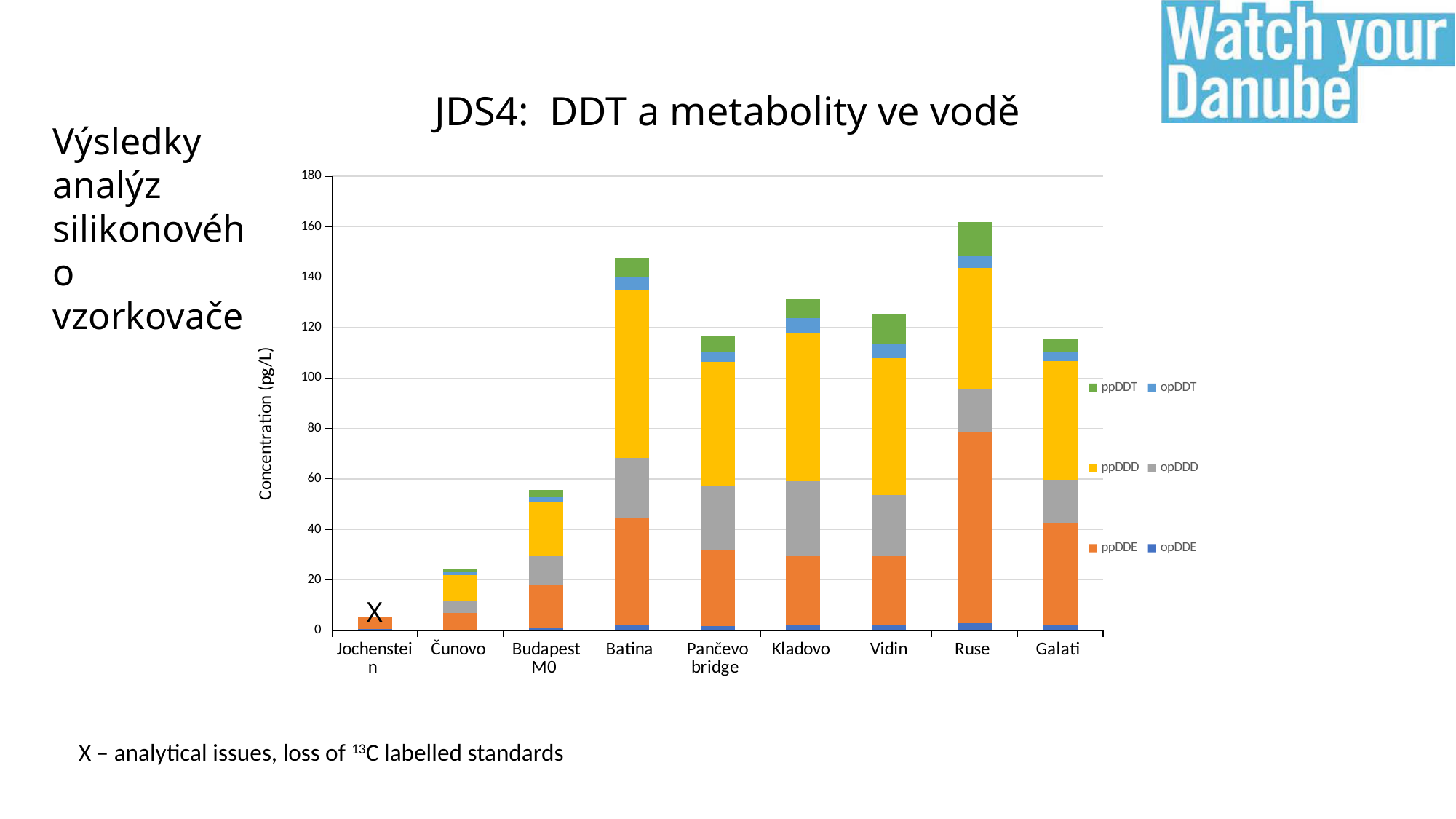
How many series does the legend list? 6 Is the total concentration for Galati greater or less than 100? greater Is the total concentration for Budapest M0 greater or less than 60? less Which site has the lowest total concentration? Jochenstein Which site is marked with an X indicating analytical issues? Jochenstein How many sampling sites (categories) are shown on the x axis? 9 What kind of chart is shown on the slide? Stacked bar chart Is the total concentration for Batina greater or less than 140? greater What is the label of the y axis? Concentration (pg/L) Which has the larger total concentration, Batina or Pančevo bridge? Batina Which site has the highest total concentration? Ruse